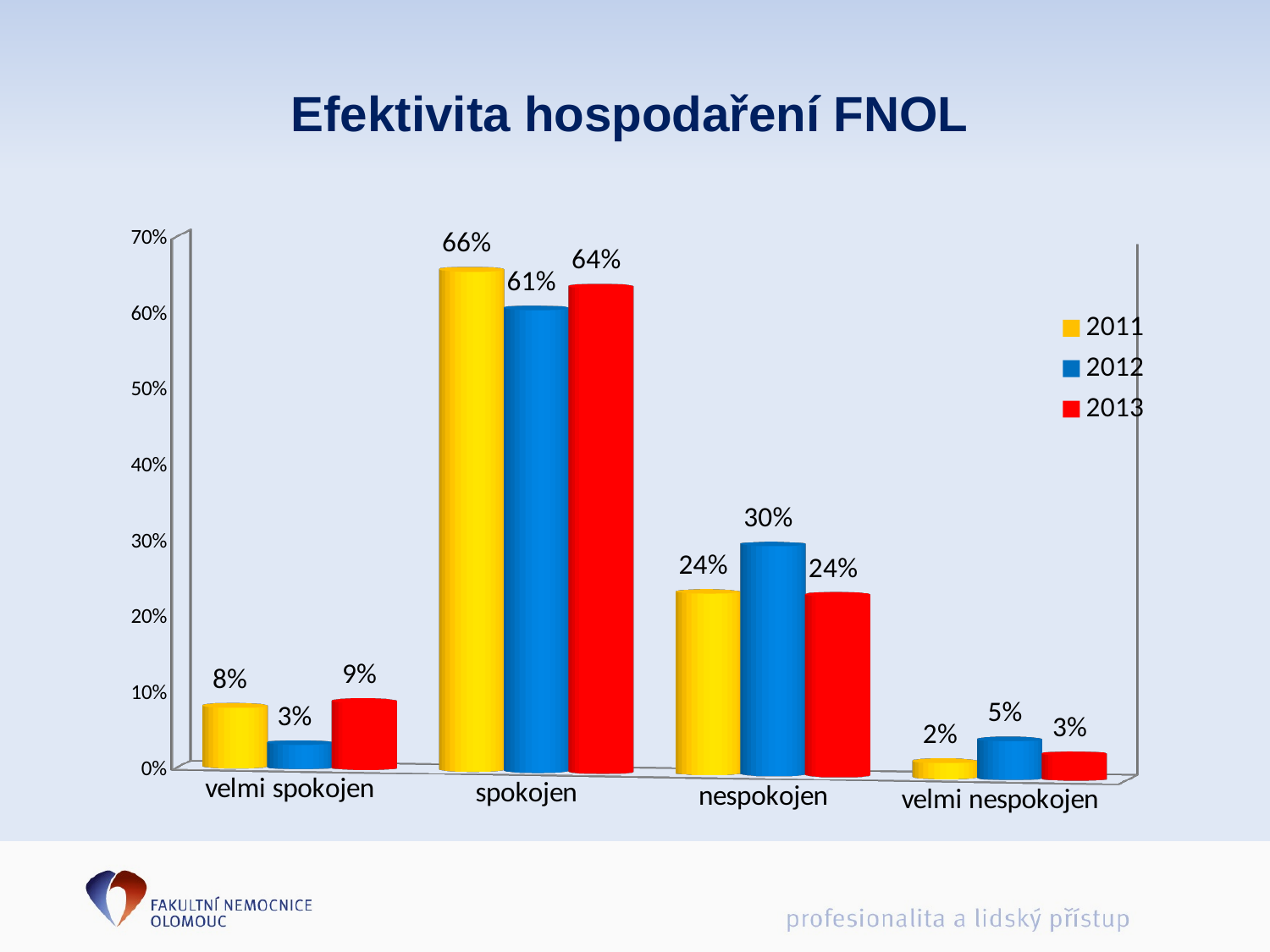
How many series does the legend list? 3 How many categories are shown on the x axis? 4 Which category has the lowest value in 2013? velmi nespokojen What is the value for 'nespokojen' in 2012? 30% What is the value for 'velmi nespokojen' in 2011? 2% What is the difference between the 2011 and 2012 values for 'spokojen'? 5% What is the value for 'velmi spokojen' in 2013? 9% What is the title of the slide? Efektivita hospodaření FNOL What kind of chart is shown on the slide? bar chart What is the value for 'spokojen' in 2011? 66% Which category has the highest value in 2012? spokojen Which is larger: the 2012 value for 'nespokojen' or the 2013 value for 'nespokojen'? 2012